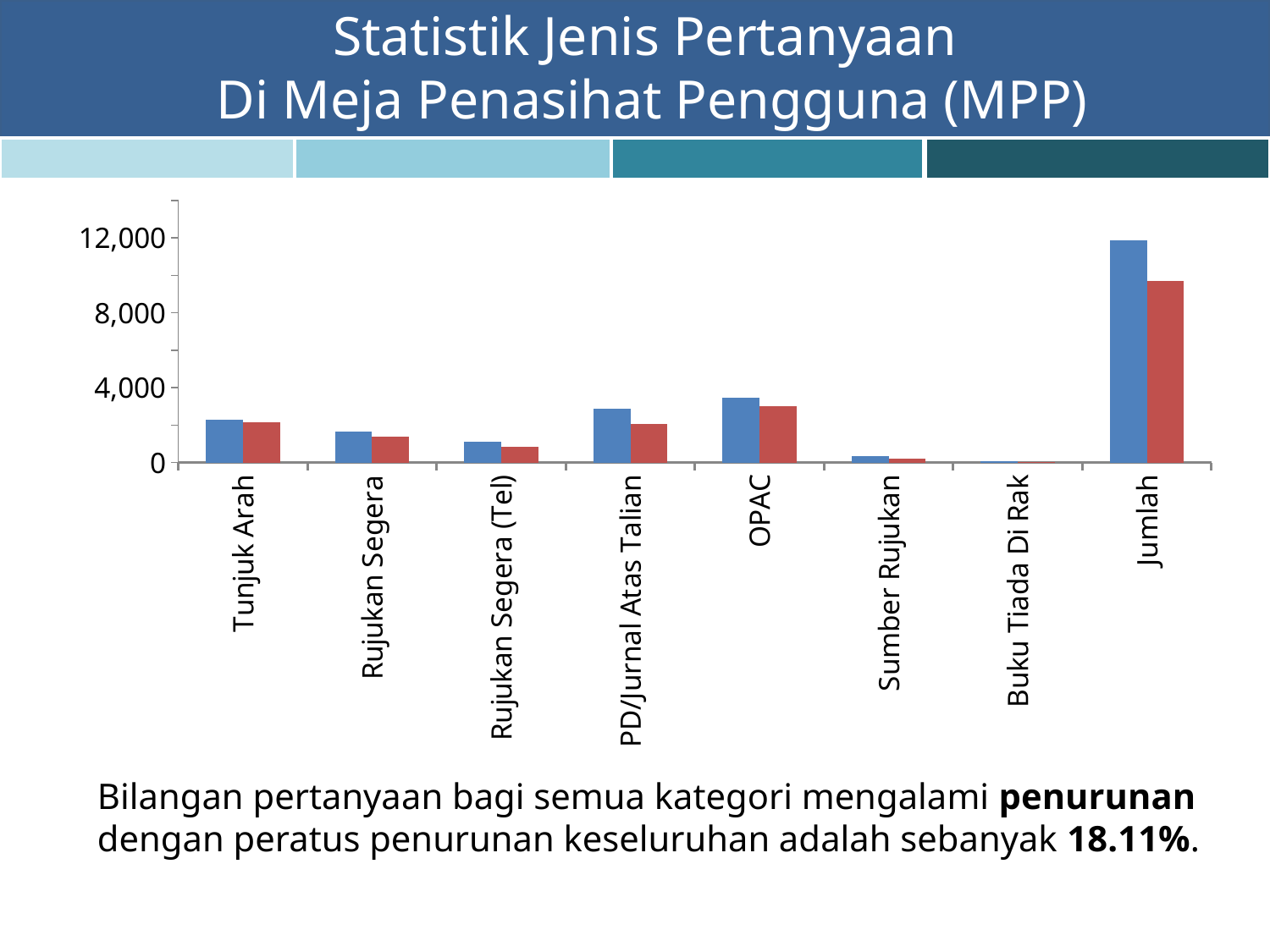
Is the blue bar for Jumlah greater or less than 8,000? greater Is the red bar for Jumlah greater or less than 12,000? less Is the red bar for Tunjuk Arah greater or less than 4,000? less What is the title shown at the top of the slide? Statistik Jenis Pertanyaan Di Meja Penasihat Pengguna (MPP) Which category has the lowest bars in the chart? Buku Tiada Di Rak For Jumlah, which bar is taller, the blue one or the red one? the blue one Which category has the highest bars in the chart? Jumlah Which category has a taller blue bar, OPAC or Tunjuk Arah? OPAC How many categories are shown on the x axis of the chart? 8 What kind of chart is shown on the slide? bar chart Which category has a taller red bar, PD/Jurnal Atas Talian or Rujukan Segera? PD/Jurnal Atas Talian